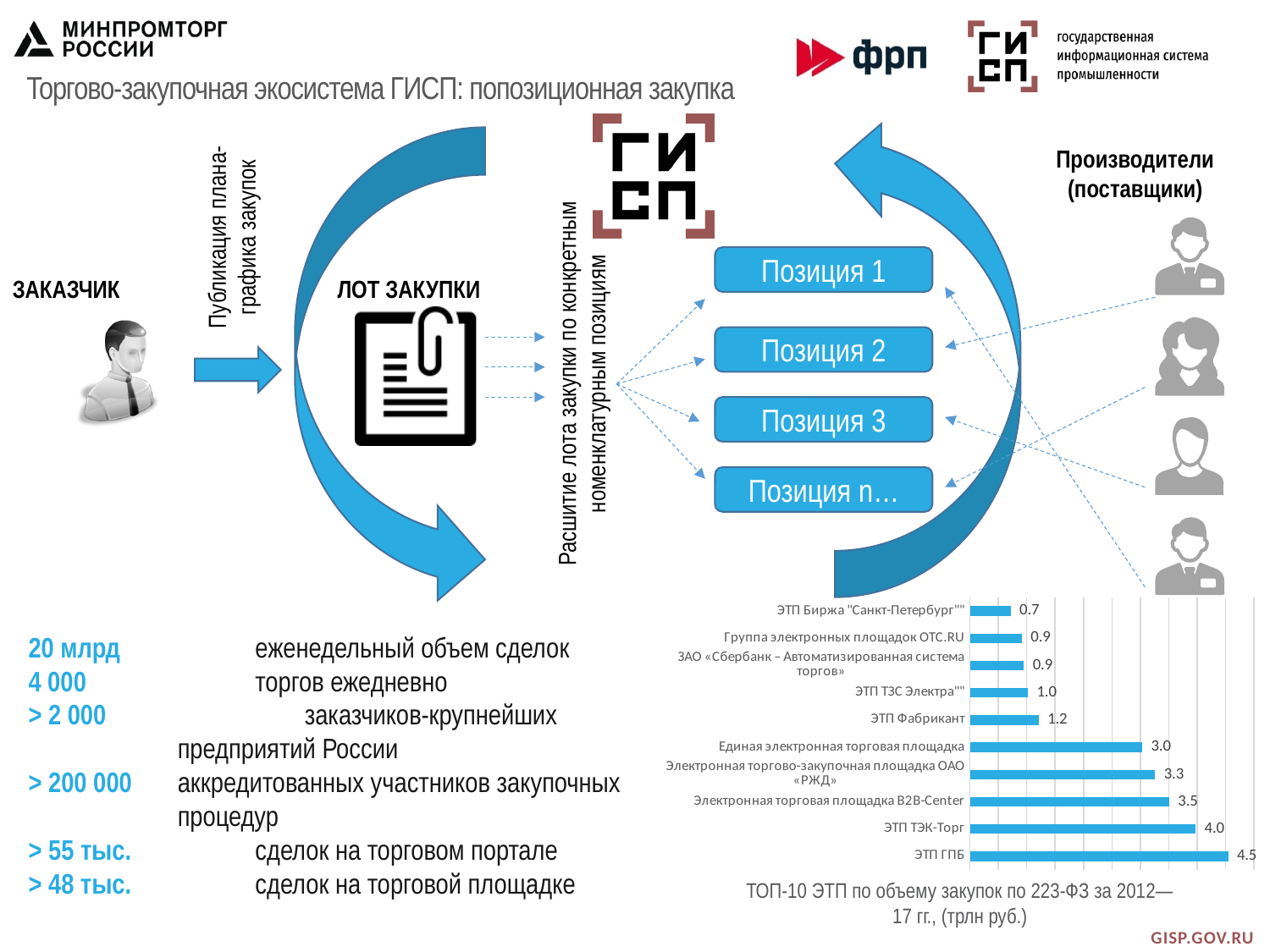
How many platforms are shown in the chart? 10 What is the difference between the values for Единая электронная торговая площадка and ЭТП Фабрикант? 1.8 Which platform has the highest value in the chart? ЭТП ГПБ What is the value for Электронная торговая площадка B2B-Center? 3.5 What type of chart is shown on the slide? Bar chart What is the value for ЭТП Фабрикант? 1.2 What is the value for ЭТП ТЭК-Торг? 4.0 Which platform has the lowest value in the chart? ЭТП Биржа "Санкт-Петербург" What is the value for ЭТП ГПБ in the chart? 4.5 Which has a larger value: Электронная торгово-закупочная площадка ОАО «РЖД» or Единая электронная торговая площадка? Электронная торгово-закупочная площадка ОАО «РЖД» What unit is given in the chart title? трлн руб. What is the difference between the values for ЭТП ГПБ and ЭТП ТЭК-Торг? 0.5